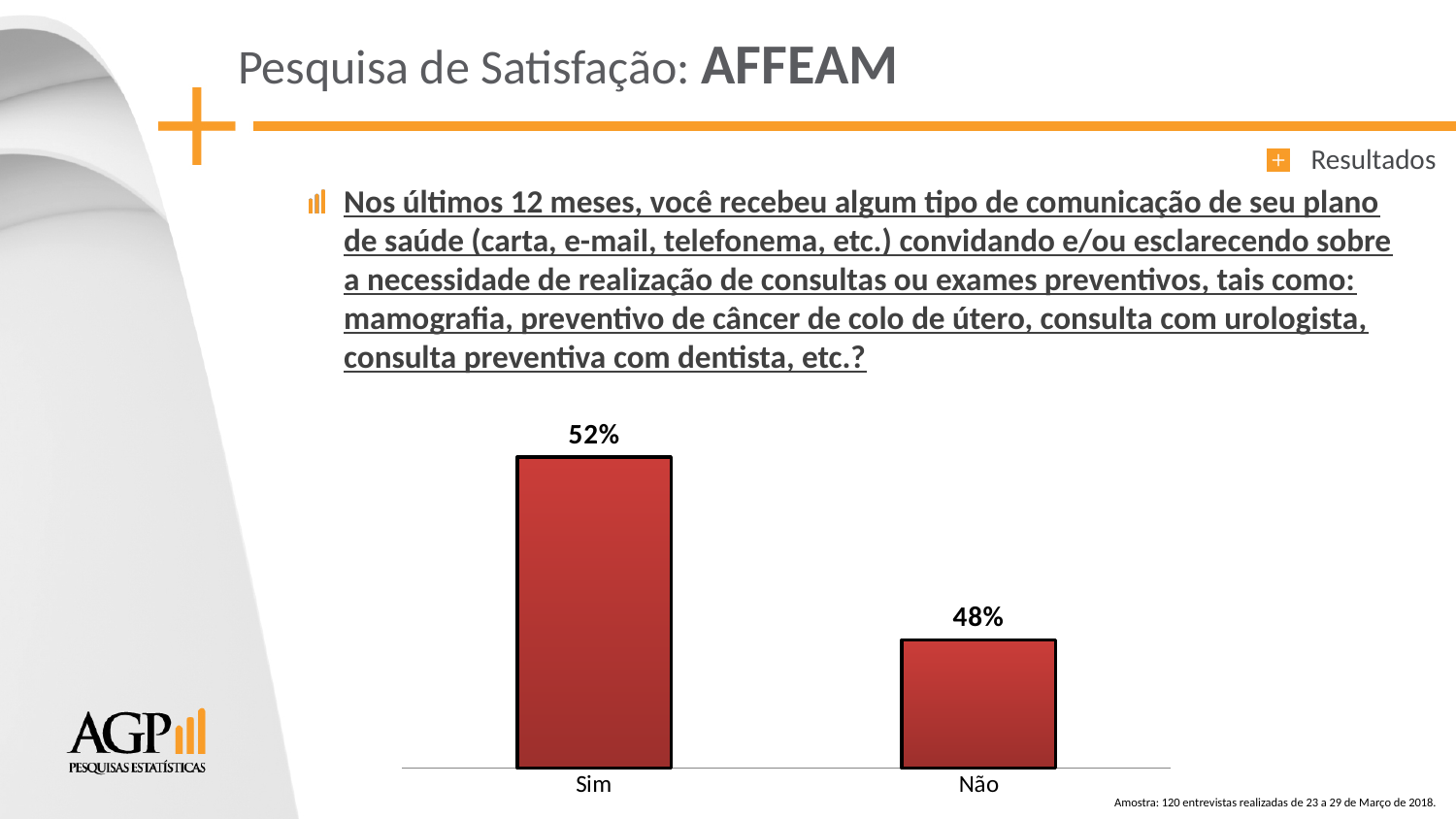
How many categories are shown in the chart? 2 What is the value for "Sim"? 52% What is the value for "Não"? 48% What kind of chart is shown on the slide? Bar chart Which is larger, the value for "Sim" or the value for "Não"? Sim Do the values rise or fall from "Sim" to "Não"? Fall What is the total of the two values shown in the chart? 100% What colour are the bars in the chart? Red What are the two category labels on the x axis of the chart? Sim and Não Which category has the lowest value? Não Which category has the highest value? Sim What is the difference between the values for "Sim" and "Não"? 4%